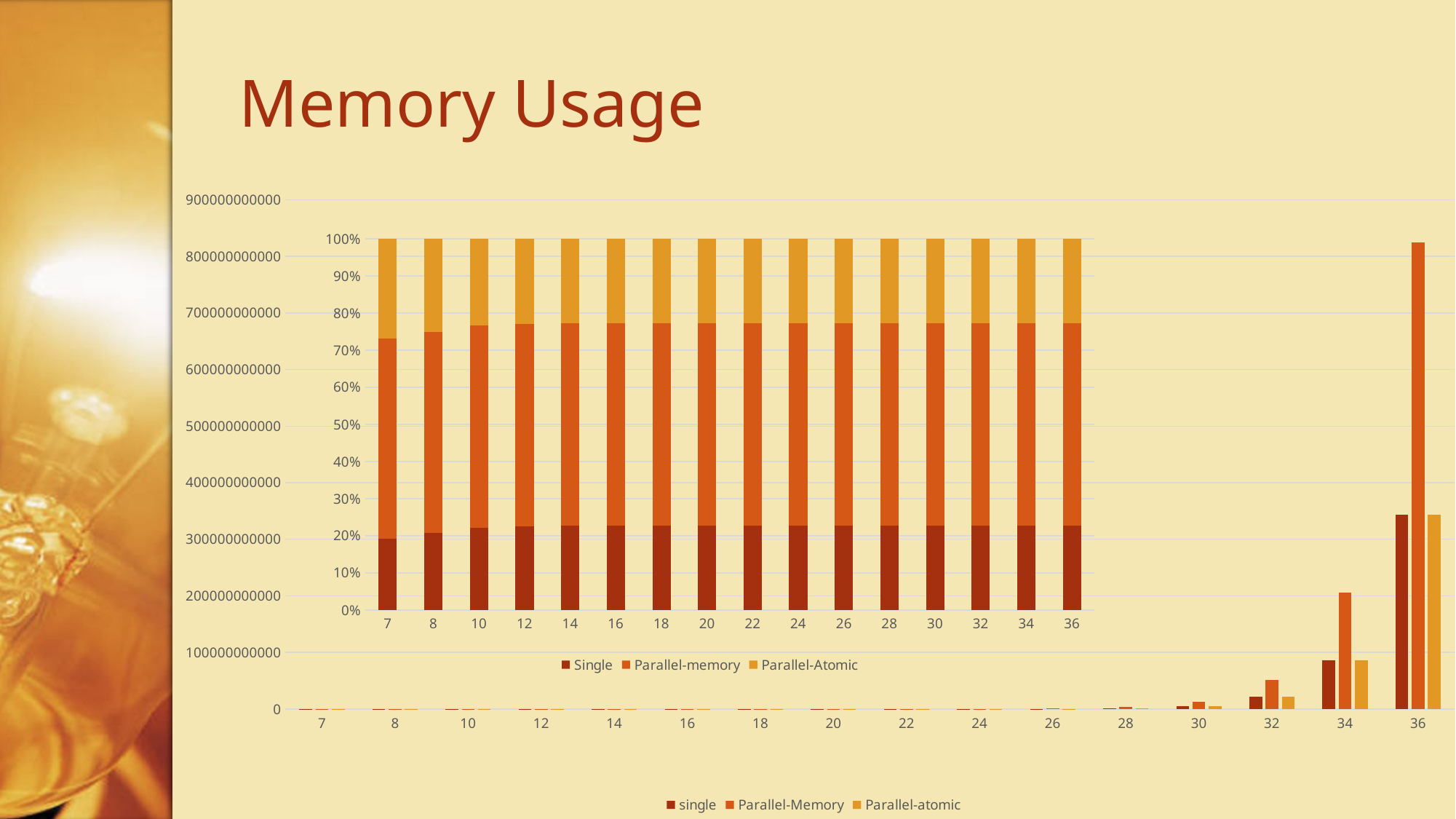
In the large bar chart, at category 36, which is larger: single or Parallel-Memory? Parallel-Memory In the large bar chart, is the Parallel-Memory value at 36 greater or less than 800000000000? greater How many categories are shown on the x axis of the inset stacked bar chart? 16 What kind of chart is the large chart with the y axis running from 0 to 900000000000? bar chart In the inset stacked bar chart, is the Parallel-memory share at 36 greater or less than 40%? greater What kind of chart is the inset chart with the percentage axis? stacked bar chart In the inset stacked bar chart, is the Single share at 7 greater or less than 30%? less In the large bar chart, which category has the highest Parallel-Memory value? 36 How many series does the legend of the large bar chart list? 3 In the large bar chart, do the Parallel-Memory values rise or fall as you move from 7 to 36 along the x axis? rise What is the title of the slide containing the charts? Memory Usage